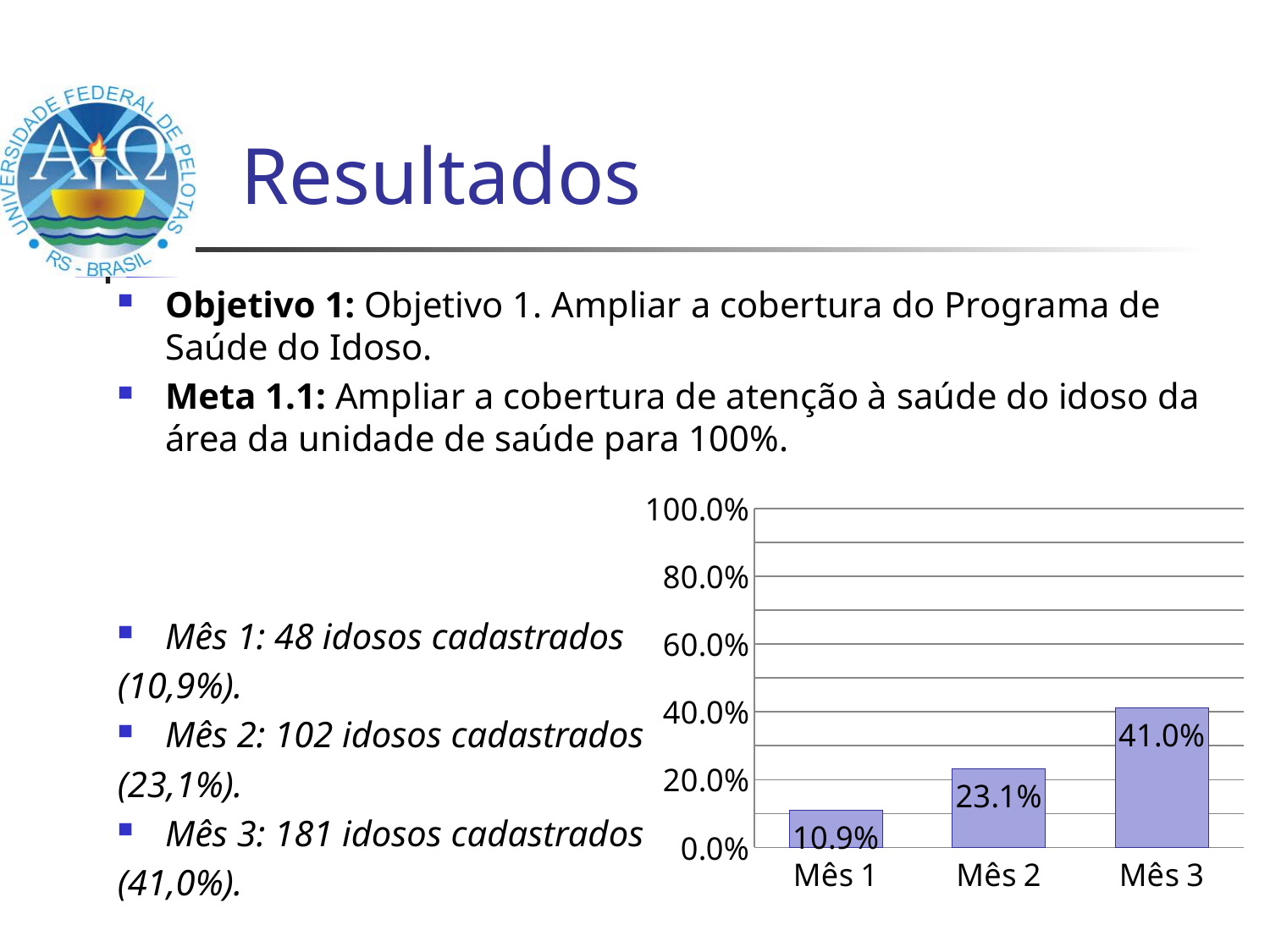
Which month has the lowest value? Mês 1 Which is larger, the value for Mês 2 or the value for Mês 3? Mês 3 What is the value for Mês 1? 10.9% Is the value for Mês 3 greater or less than 40.0%? greater Do the values rise or fall from Mês 1 to Mês 3? rise What is the difference between the values for Mês 3 and Mês 1? 30.1% What is the value for Mês 2? 23.1% Which month has the highest value? Mês 3 What is the value for Mês 3? 41.0% How many months are shown on the chart? 3 What is the difference between the values for Mês 2 and Mês 1? 12.2% What kind of chart is shown on the slide? bar chart